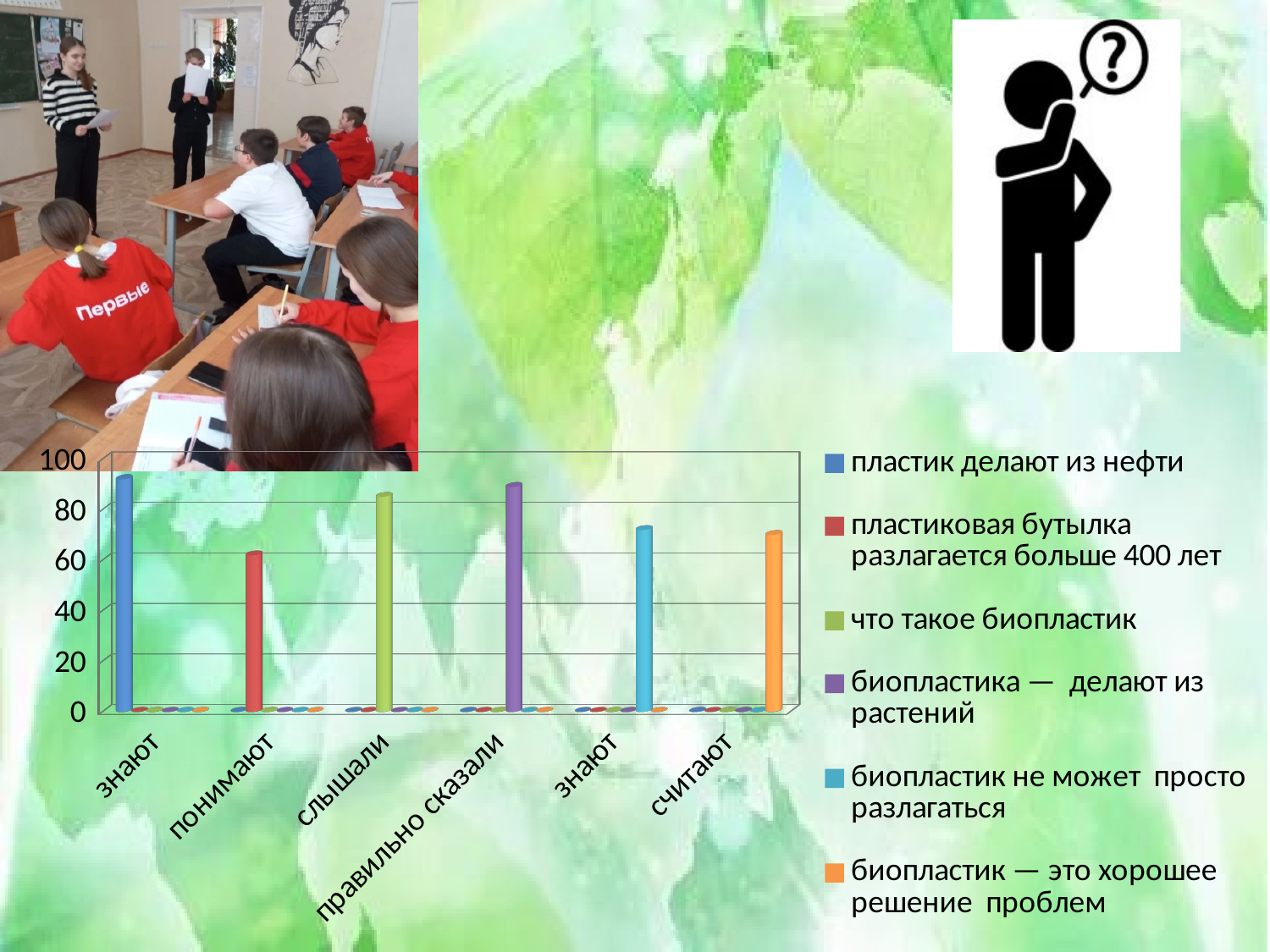
Is the value for понимают greater or less than 80? less Is the value for понимают greater or less than 40? greater Which is larger, the value for понимают or the value for слышали? слышали How many series does the legend list? 6 Is the value for считают greater or less than 80? less Which category has the lowest value? понимают What kind of chart is shown on the slide? bar chart How many categories are shown along the x axis of the chart? 6 Which legend entry is shown in blue? пластик делают из нефти Which colour represents the series 'что такое биопластик' in the legend? green